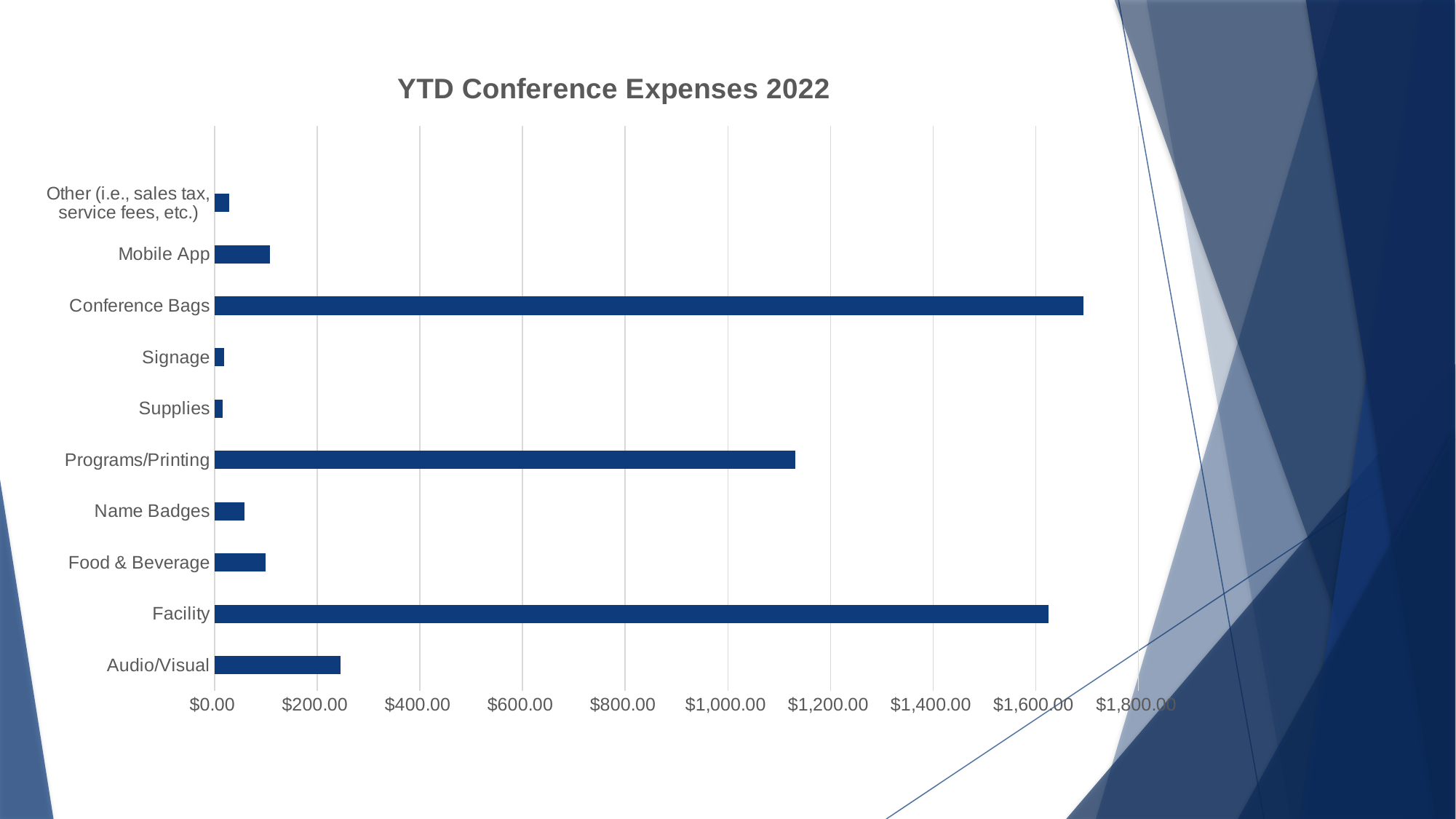
How many expense categories are plotted in the chart? 10 What kind of chart is shown on the slide? bar chart What is the title of the chart? YTD Conference Expenses 2022 Is the value for Mobile App greater or less than $200.00? less Is the value for Facility greater or less than $1,400.00? greater Is the value for Conference Bags greater or less than $1,600.00? greater Which is larger, the value for Conference Bags or the value for Programs/Printing? Conference Bags Which is larger, the value for Audio/Visual or the value for Name Badges? Audio/Visual Which expense category has the highest value? Conference Bags